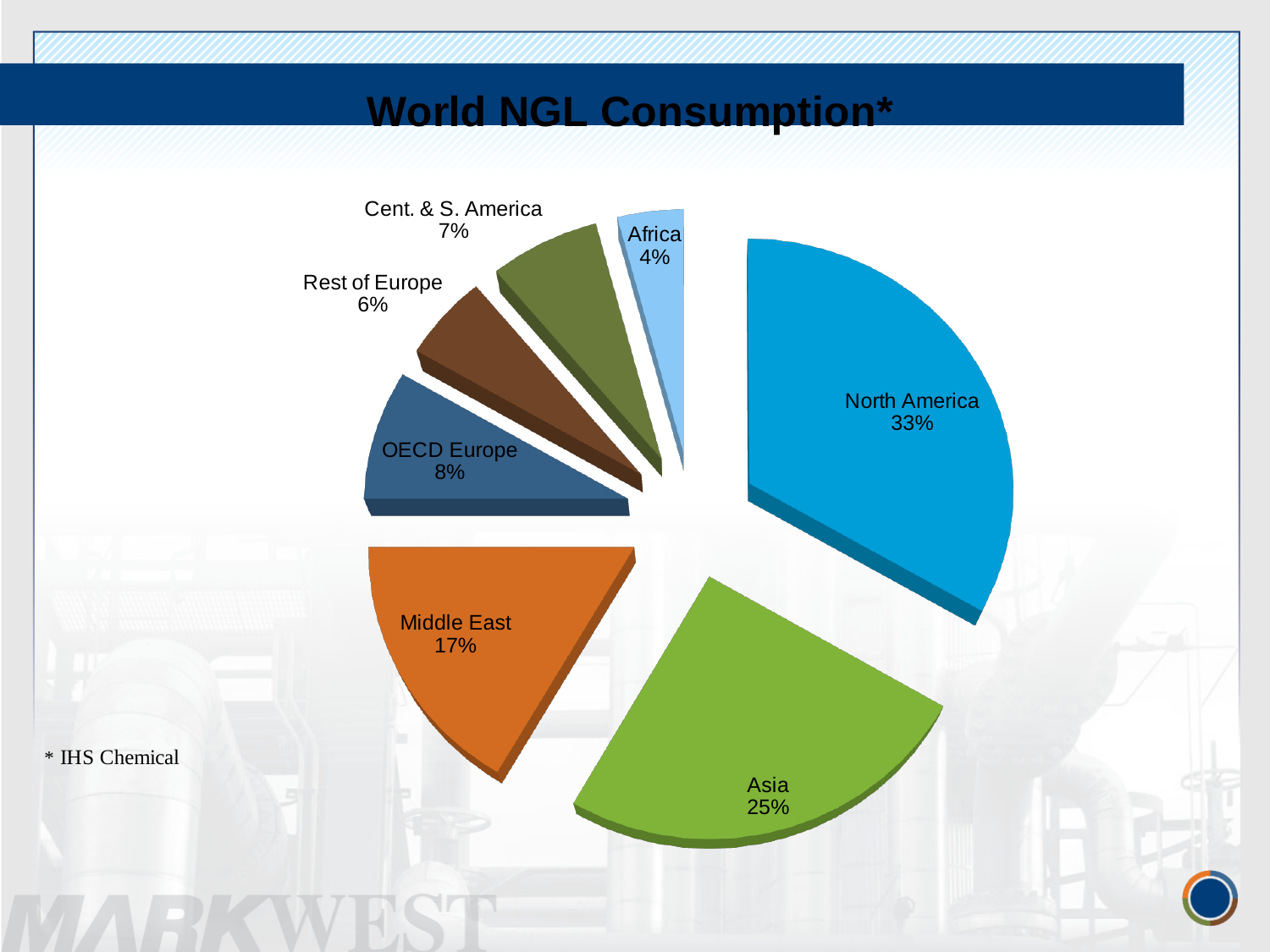
What is the difference in percentage points between North America and Asia? 8 Which has a larger share, Rest of Europe or OECD Europe? OECD Europe How many regions are shown in the pie chart? 7 What is the title of the chart? World NGL Consumption* What share is shown for Cent. & S. America? 7% Which region has the largest share of world NGL consumption? North America What is the value shown for Asia? 25% What share of world NGL consumption does North America account for? 33% What type of chart is shown on the slide? Pie chart What percentage is shown for the Middle East slice? 17% Which region has the smallest share of world NGL consumption? Africa What is the value for OECD Europe? 8%